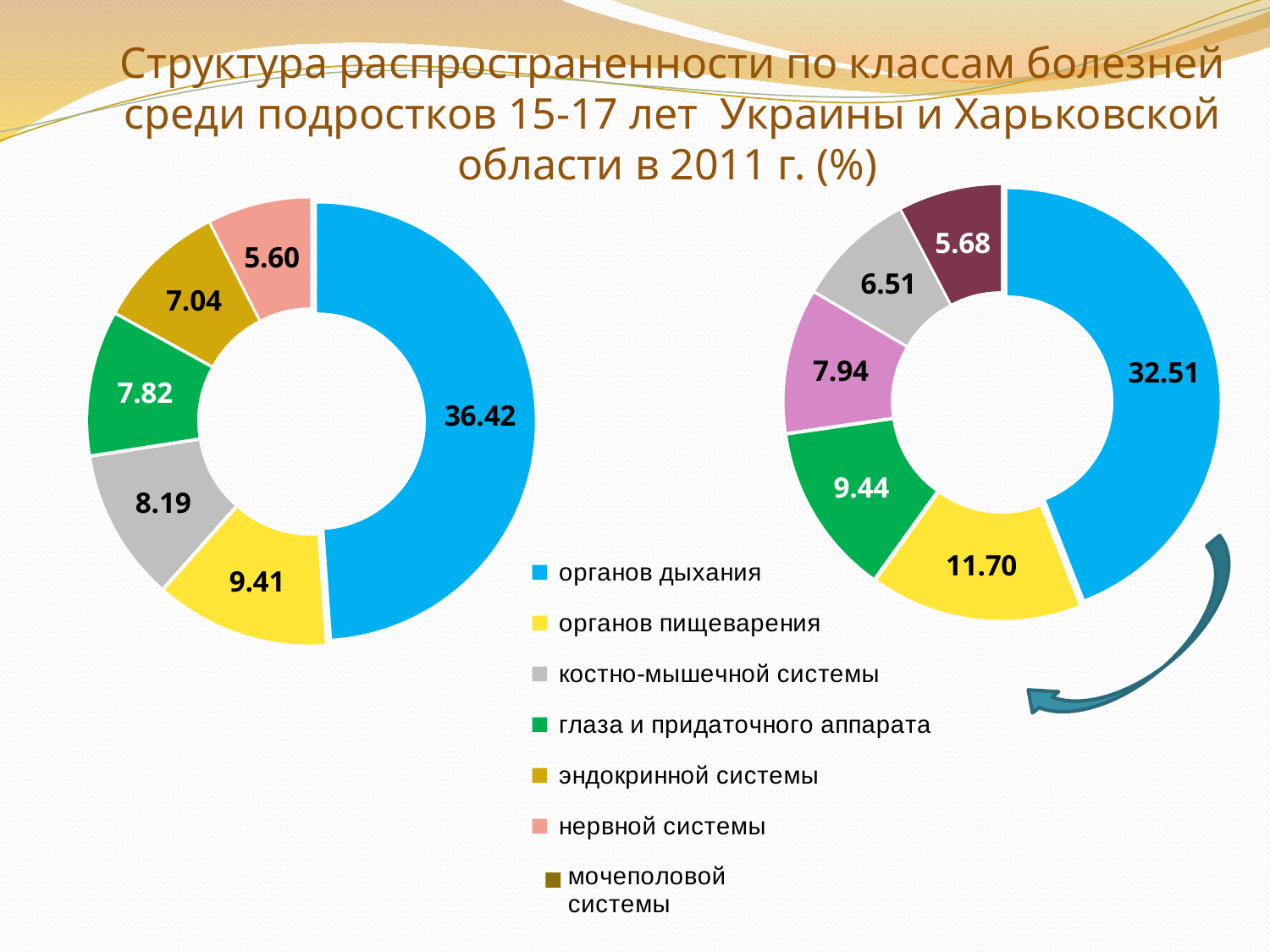
In the left chart, what is the value for костно-мышечной системы? 8.19 In the left chart, what is the value for органов пищеварения? 9.41 Which chart shows a larger value for органов дыхания, the left chart or the right chart? the left chart In the left chart, which category has the smallest slice? нервной системы In the left chart, which category has the largest slice? органов дыхания What type of chart is used on this slide? doughnut (pie) chart In the left chart, what is the value for органов дыхания? 36.42 How many slices does the left chart have? 6 In the right chart, what is the value for органов дыхания? 32.51 In the left chart, what is the difference between the values for органов дыхания and органов пищеварения? 27.01 In the right chart, what is the value for органов пищеварения? 11.70 In the right chart, what is the value for глаза и придаточного аппарата? 9.44